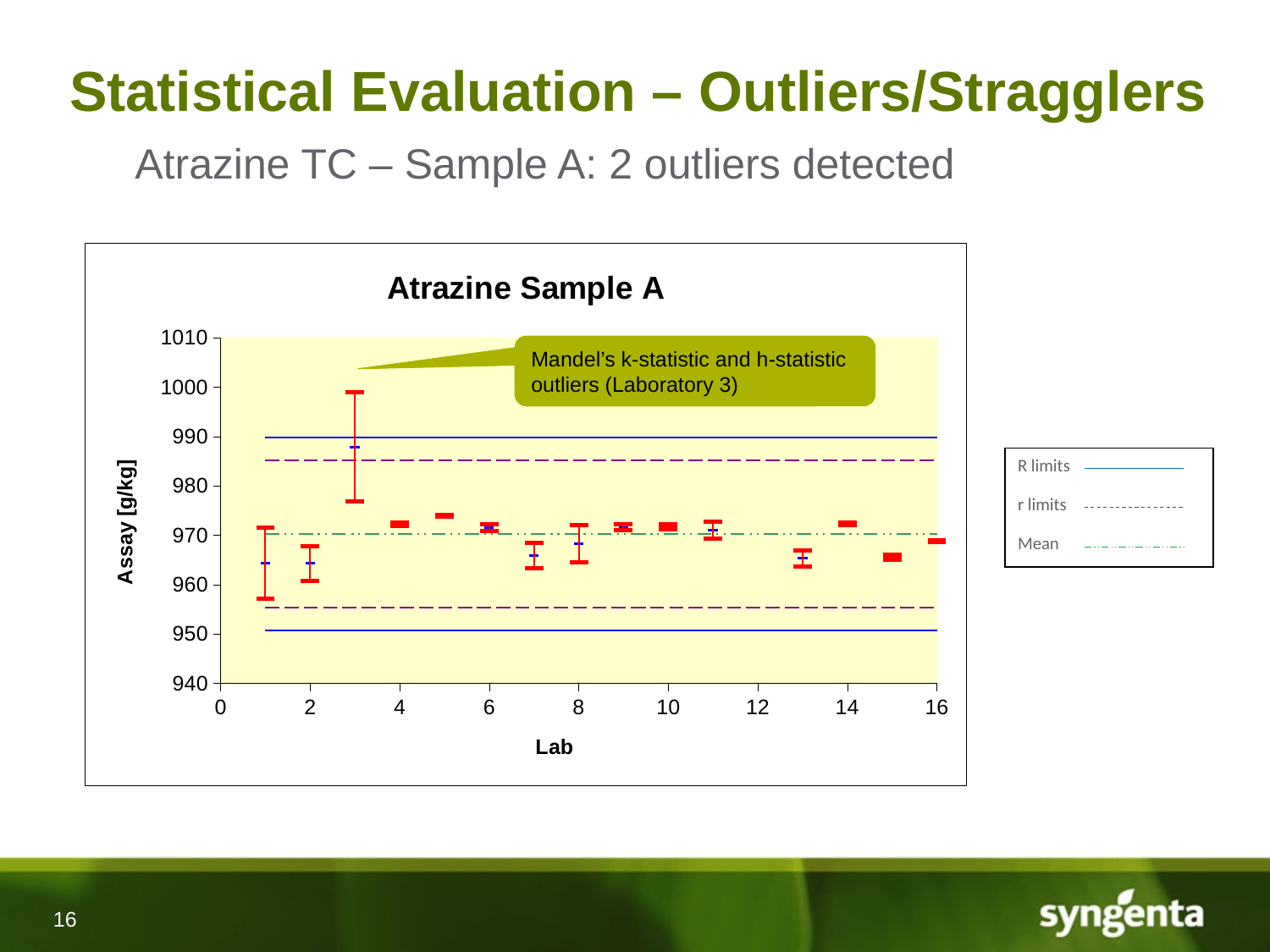
What is the title of the chart? Atrazine Sample A Which lab is larger in value, Lab 14 or Lab 13? Lab 14 Which lab has the lowest lower value on the chart? Lab 1 How many labs are plotted on the chart? 15 Is the value for Lab 15 greater or less than 970? less How many entries does the chart legend list? 3 Is the lower end of the range for Lab 1 greater or less than 960? less Is the upper end of the range for Lab 3 greater or less than 990? greater Which laboratory is identified in the callout as the Mandel's k-statistic and h-statistic outlier? Laboratory 3 What are the three entries in the chart legend? R limits, r limits, Mean Which lab has the highest upper value on the chart? Lab 3